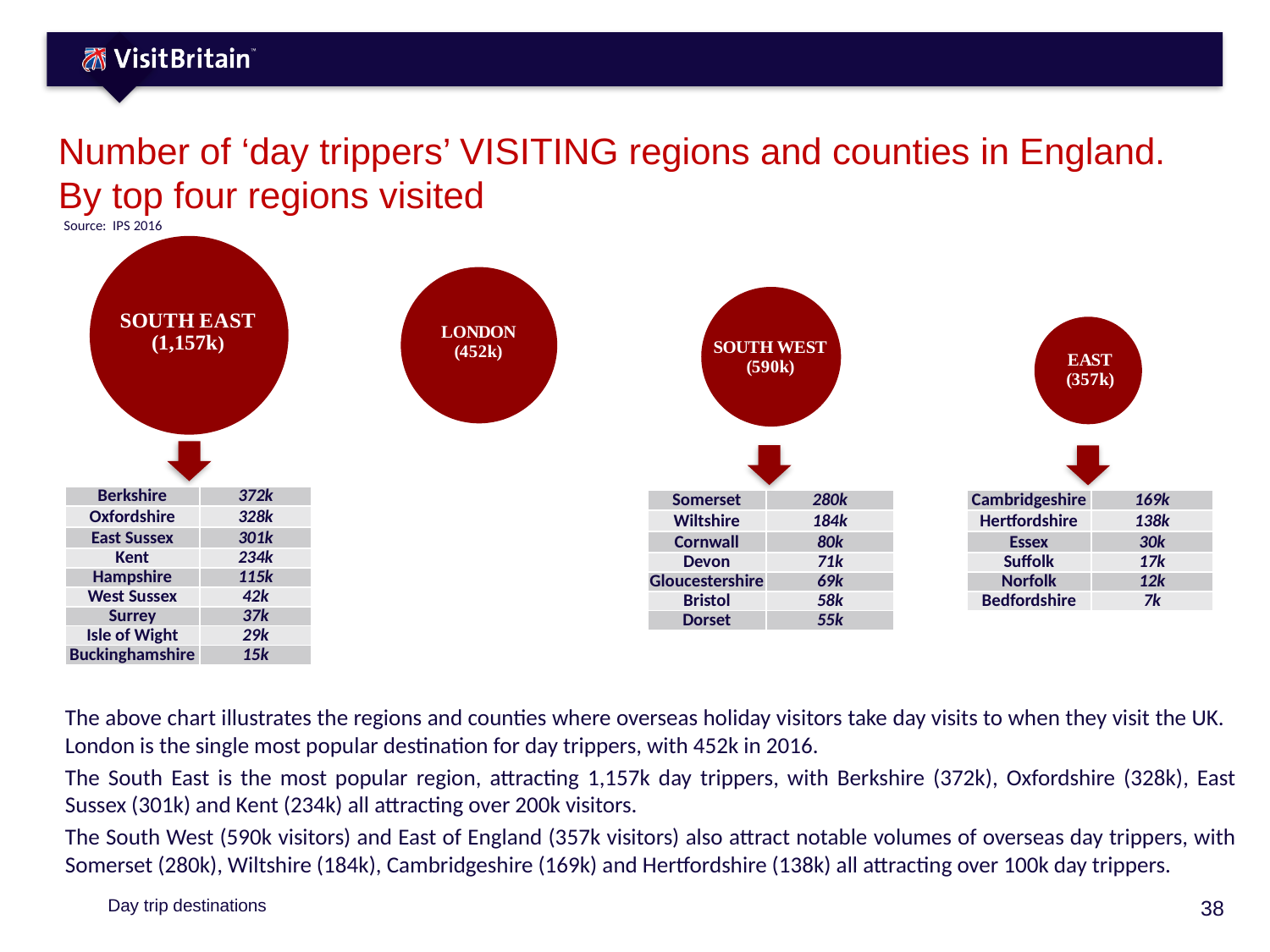
How many regions are shown as circles on the slide? 4 What is the difference in day trippers between Cambridgeshire and Hertfordshire? 31k Which of the four regions shown had the most day trippers? South East What is the difference in day trippers between the South West and the East region? 233k Which of the four regions shown had the fewest day trippers? East How many day trippers visited London? 452k How many day trippers visited Somerset? 280k What is the source cited for the chart? IPS 2016 In the East table, which county had the fewest day trippers? Bedfordshire Which had more day trippers, London or the South West? South West How many day trippers visited the South East region? 1,157k In the South East table, which county had the most day trippers? Berkshire